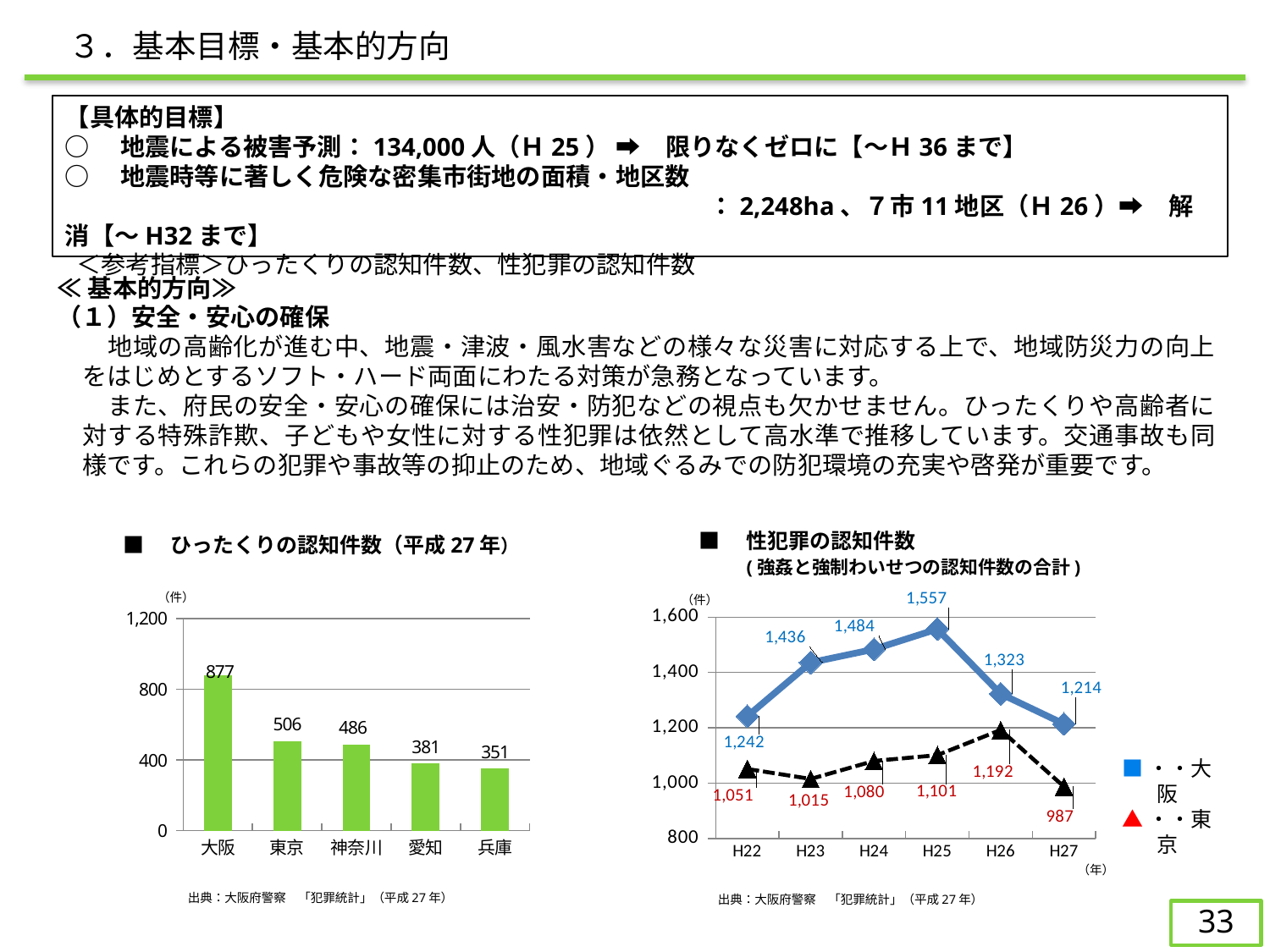
In the right chart (性犯罪の認知件数), in which year is the 東京 series highest? H26 In the right chart (性犯罪の認知件数), what is the value for 大阪 in H25? 1,557 In the right chart (性犯罪の認知件数), how many series does the legend list? 2 In the left chart (ひったくりの認知件数), what is the difference between 東京 and 神奈川? 20 In the right chart (性犯罪の認知件数), what is the value for 東京 in H27? 987 In the left chart (ひったくりの認知件数), which prefecture has the lowest value? 兵庫 In the right chart (性犯罪の認知件数), does the 大阪 series rise or fall from H25 to H27? fall In the left chart (ひったくりの認知件数), how many prefectures are shown? 5 In the right chart (性犯罪の認知件数), what is the difference between 大阪 and 東京 in H22? 191 What kind of chart is the left chart (ひったくりの認知件数)? bar chart In the right chart (性犯罪の認知件数), which is larger in H26, 大阪 or 東京? 大阪 In the left chart (ひったくりの認知件数), what is the value for 大阪? 877